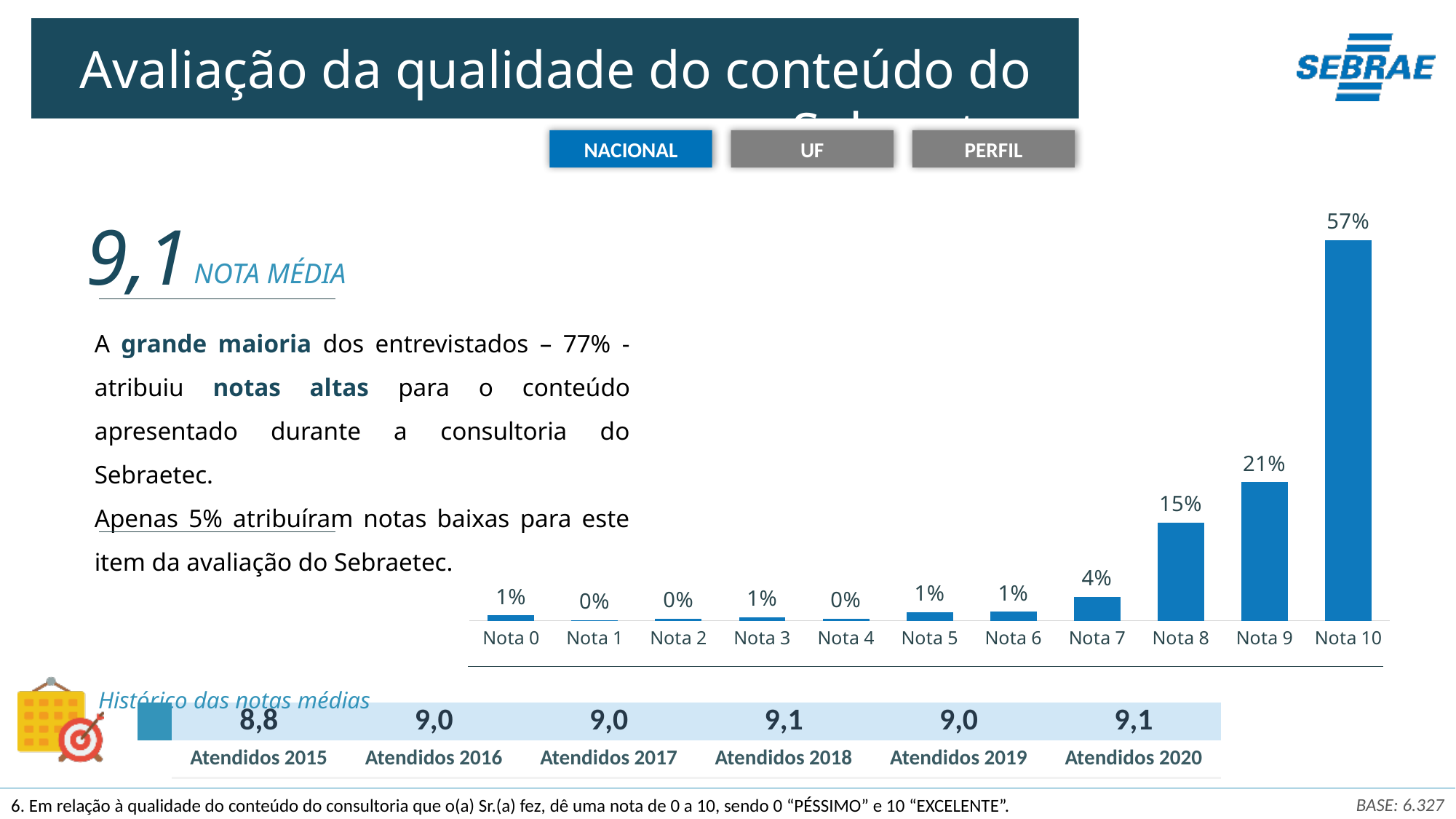
What percentage of respondents gave Nota 10? 57% What is the value shown for Nota 8? 15% What type of chart is used to show the distribution of notas? Bar chart What is the difference between the values for Nota 9 and Nota 8? 6% What is the value shown for Nota 7? 4% Which has a larger value, Nota 8 or Nota 9? Nota 9 How many categories (bars) are shown in the chart? 11 What is the value shown for Nota 0? 1% Do the values generally rise or fall from Nota 0 to Nota 10? Rise What is the value shown for Nota 9? 21% What is the difference between the values for Nota 10 and Nota 9? 36% Which category has the highest value in the bar chart? Nota 10